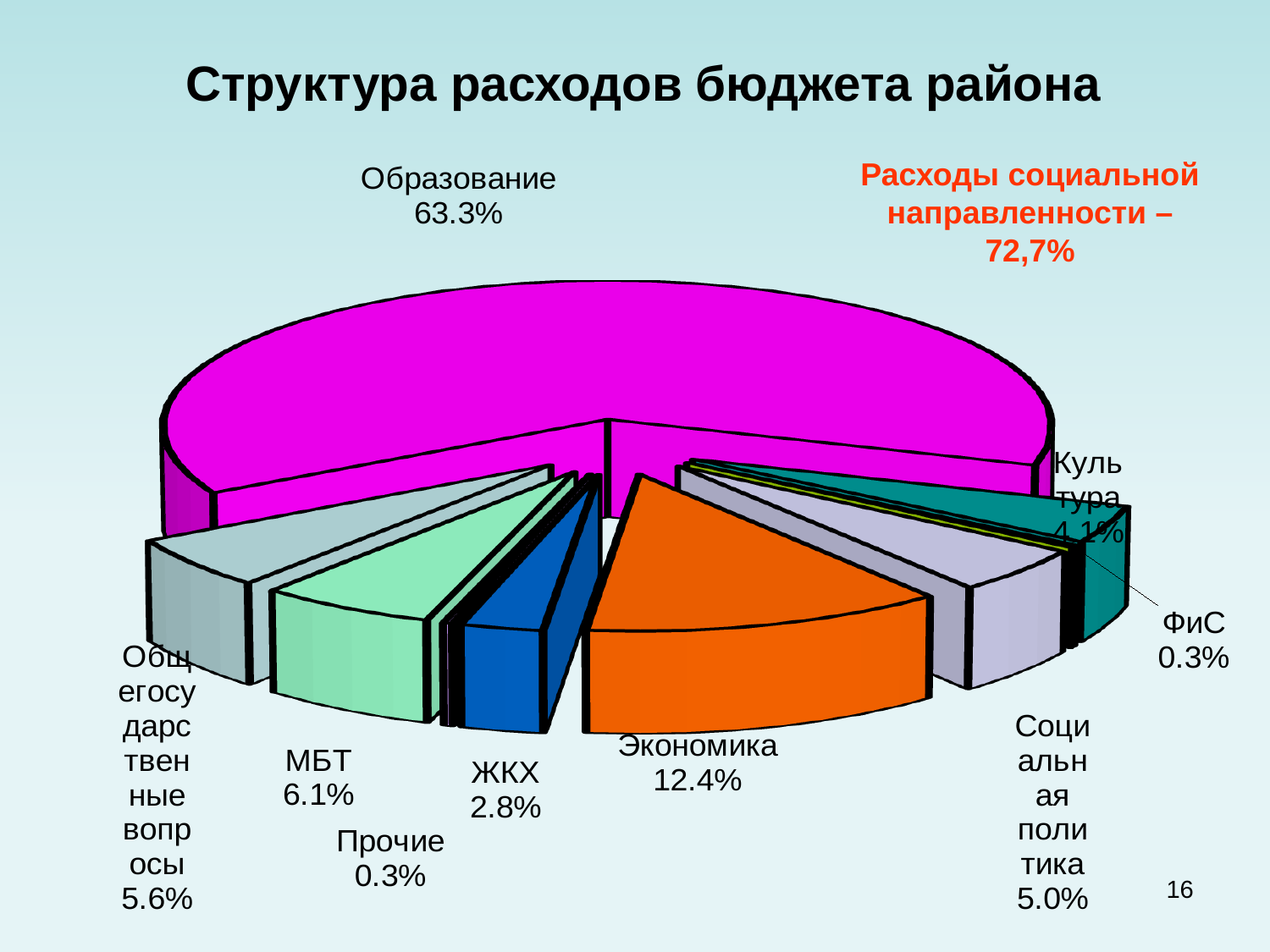
What is the value shown for МБТ? 6.1% What is the value shown for Социальная политика? 5.0% What is the difference between the shares of Образование and Экономика? 50.9% What kind of chart is shown on the slide? pie chart What share of the pie does Образование have? 63.3% What is the title of the chart? Структура расходов бюджета района What is the value shown for Экономика? 12.4% Which category has the largest share of the pie? Образование How many categories are shown in the pie chart? 9 What is the value shown for ЖКХ? 2.8% Which category is larger, Экономика or МБТ? Экономика What is the difference between the shares of МБТ and Общегосударственные вопросы? 0.5%